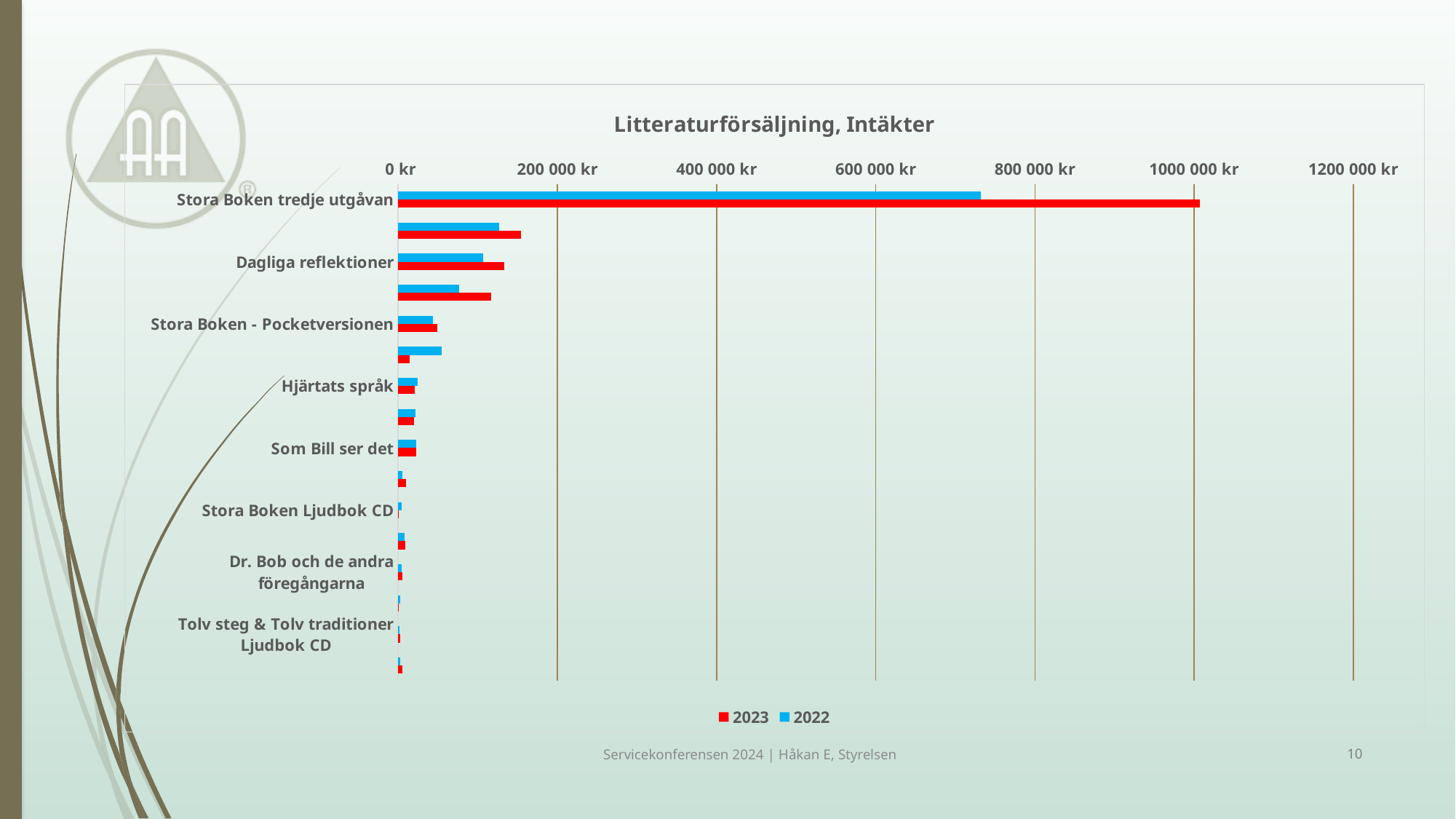
Which category has the highest value in the chart? Stora Boken tredje utgåvan What kind of chart is shown on the slide? bar chart For Stora Boken tredje utgåvan, which series has the larger value, 2023 or 2022? 2023 Is the 2023 value for Stora Boken - Pocketversionen greater or less than 200 000 kr? less What is the title of the chart? Litteraturförsäljning, Intäkter Which colour represents the 2023 series in the chart? red For Dagliga reflektioner, which series has the larger value, 2023 or 2022? 2023 Is the 2022 value for Stora Boken tredje utgåvan greater or less than 600 000 kr? greater Is the 2023 value for Stora Boken tredje utgåvan greater or less than 800 000 kr? greater How many series does the legend list? 2